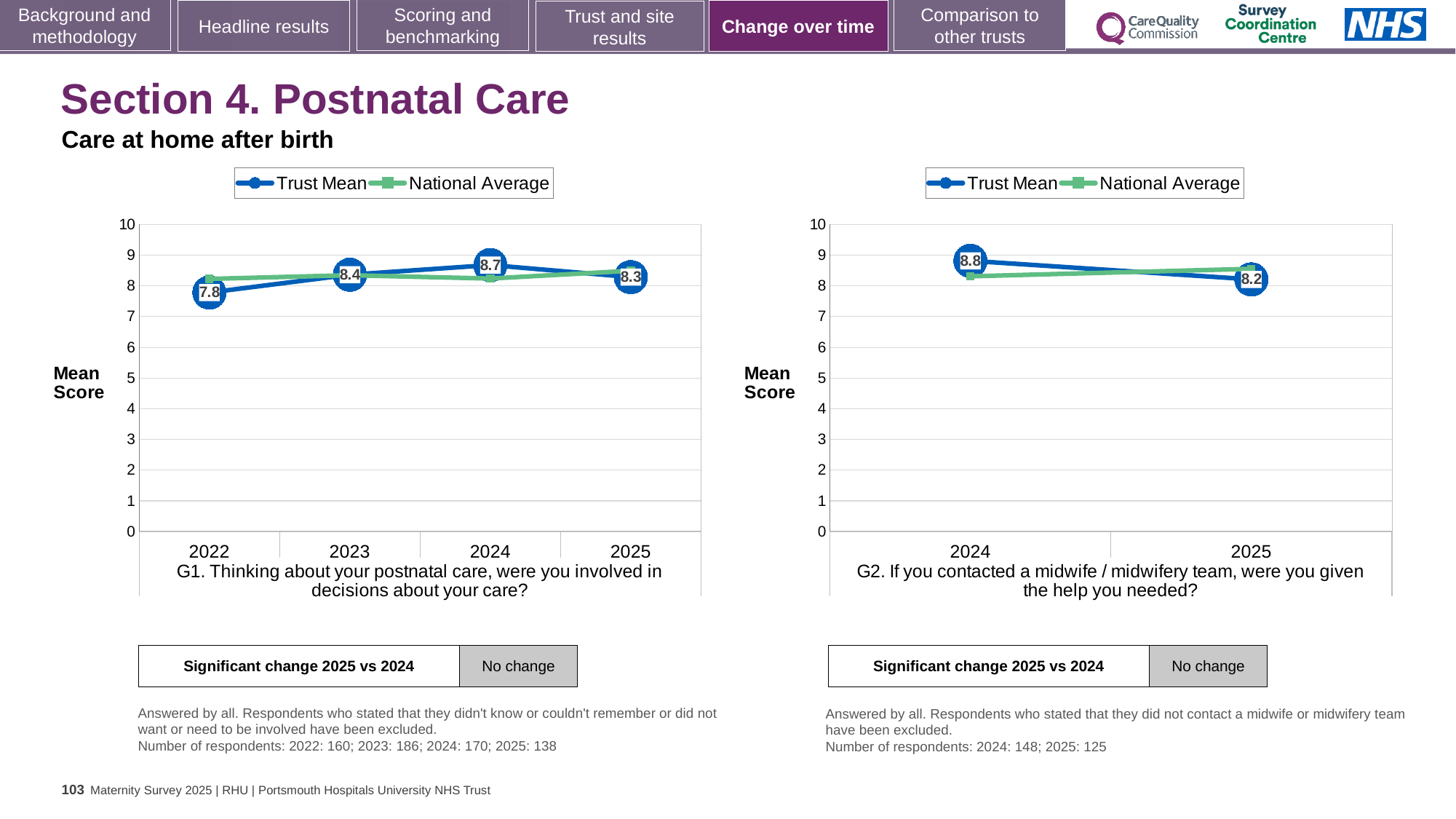
On the left chart (G1), what is the Trust Mean for 2022? 7.8 On the left chart (G1), is the National Average for 2022 greater or less than 7? greater On the left chart (G1), which year has the highest Trust Mean? 2024 On the right chart (G2), which year has the larger Trust Mean, 2024 or 2025? 2024 On the left chart (G1), what is the difference between the Trust Mean in 2024 and in 2022? 0.9 On the right chart (G2), what is the Trust Mean for 2025? 8.2 On the right chart (G2), what is the difference between the Trust Mean in 2024 and in 2025? 0.6 How many years are shown on the x axis of the left chart (G1)? 4 What kind of chart is the left chart (G1)? Line chart On the left chart (G1), what is the Trust Mean for 2024? 8.7 How many series does the legend of the right chart (G2) list? 2 On the left chart (G1), which year has the lowest Trust Mean? 2022